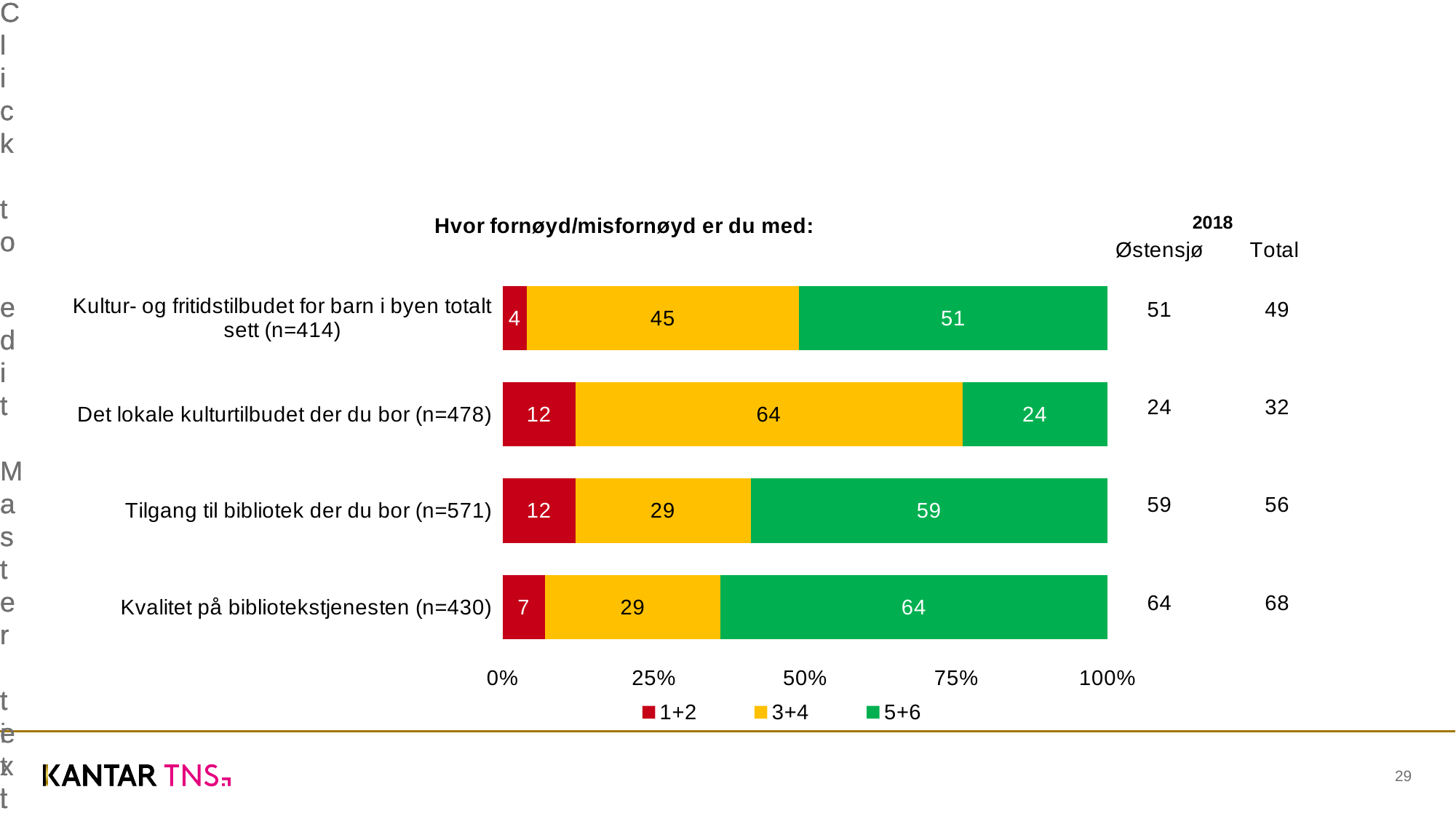
What is the value of the 3+4 series for "Det lokale kulturtilbudet der du bor (n=478)"? 64 What kind of chart is shown on the slide? Stacked bar chart What is the title of the chart? Hvor fornøyd/misfornøyd er du med: What is the difference between the 3+4 values for "Det lokale kulturtilbudet der du bor (n=478)" and "Tilgang til bibliotek der du bor (n=571)"? 35 Which category has the highest value for the 5+6 series? Kvalitet på bibliotekstjenesten (n=430) What is the value of the 1+2 series for "Kultur- og fritidstilbudet for barn i byen totalt sett (n=414)"? 4 Which is larger: the 1+2 value for "Kvalitet på bibliotekstjenesten (n=430)" or the 1+2 value for "Tilgang til bibliotek der du bor (n=571)"? Tilgang til bibliotek der du bor (n=571) What is the total of the stacked bar for "Kultur- og fritidstilbudet for barn i byen totalt sett (n=414)"? 100 How many categories are shown in the chart? 4 Which category has the lowest value for the 5+6 series? Det lokale kulturtilbudet der du bor (n=478) How many series does the legend list? 3 What is the value of the 5+6 series for "Tilgang til bibliotek der du bor (n=571)"? 59